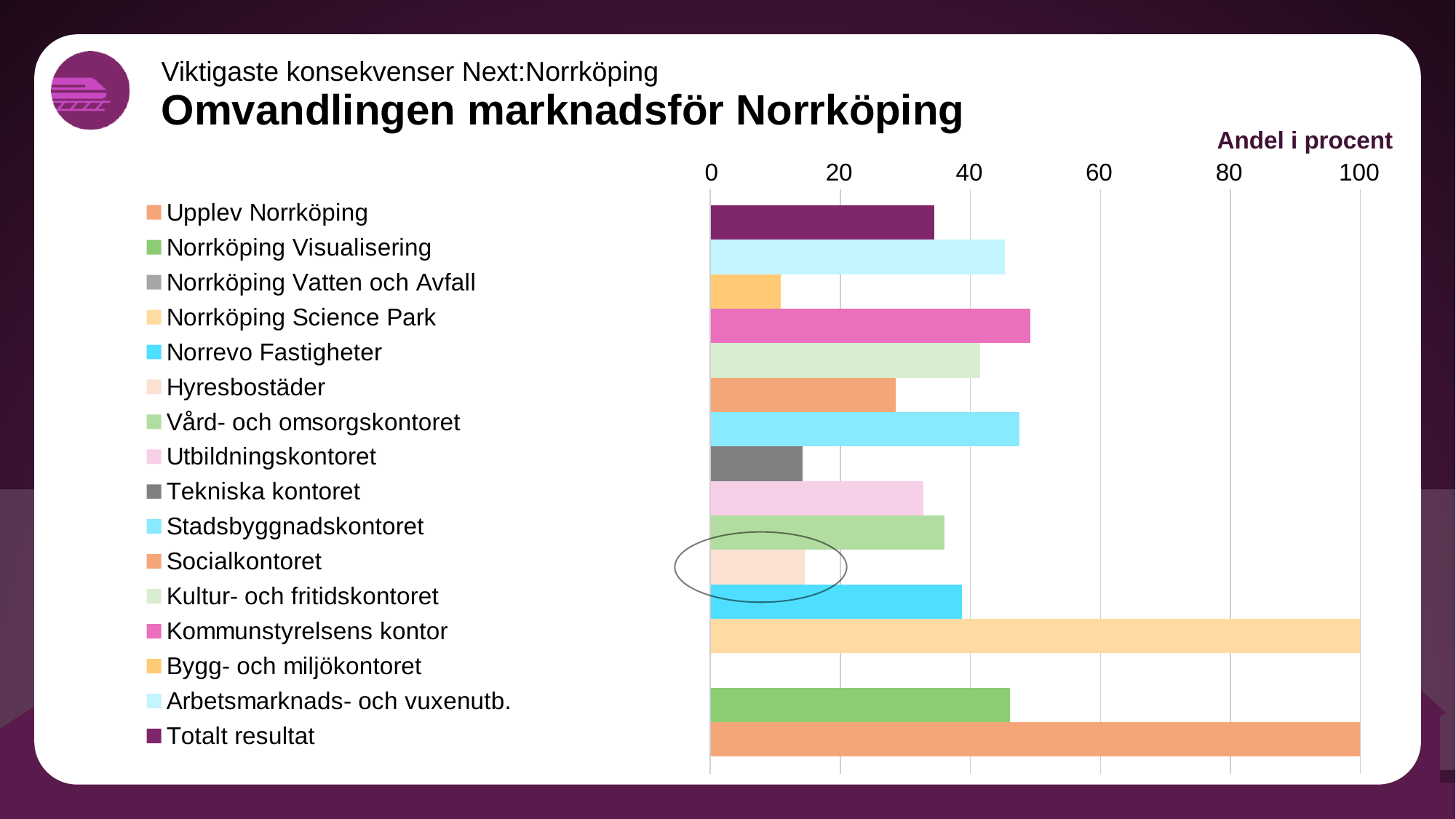
Is the value for Kommunstyrelsens kontor greater or less than 40? greater How many entries does the chart legend list? 16 What kind of chart is shown on the slide? bar chart Is the value for Totalt resultat greater or less than 40? less Is the value for Stadsbyggnadskontoret greater or less than 40? greater Which has the larger value, Kommunstyrelsens kontor or Socialkontoret? Kommunstyrelsens kontor Which category has the lowest value, showing no visible bar? Norrköping Vatten och Avfall Which has the larger value, Tekniska kontoret or Kultur- och fritidskontoret? Kultur- och fritidskontoret What label is shown above the horizontal axis of the chart? Andel i procent What is the highest value shown on the horizontal axis? 100